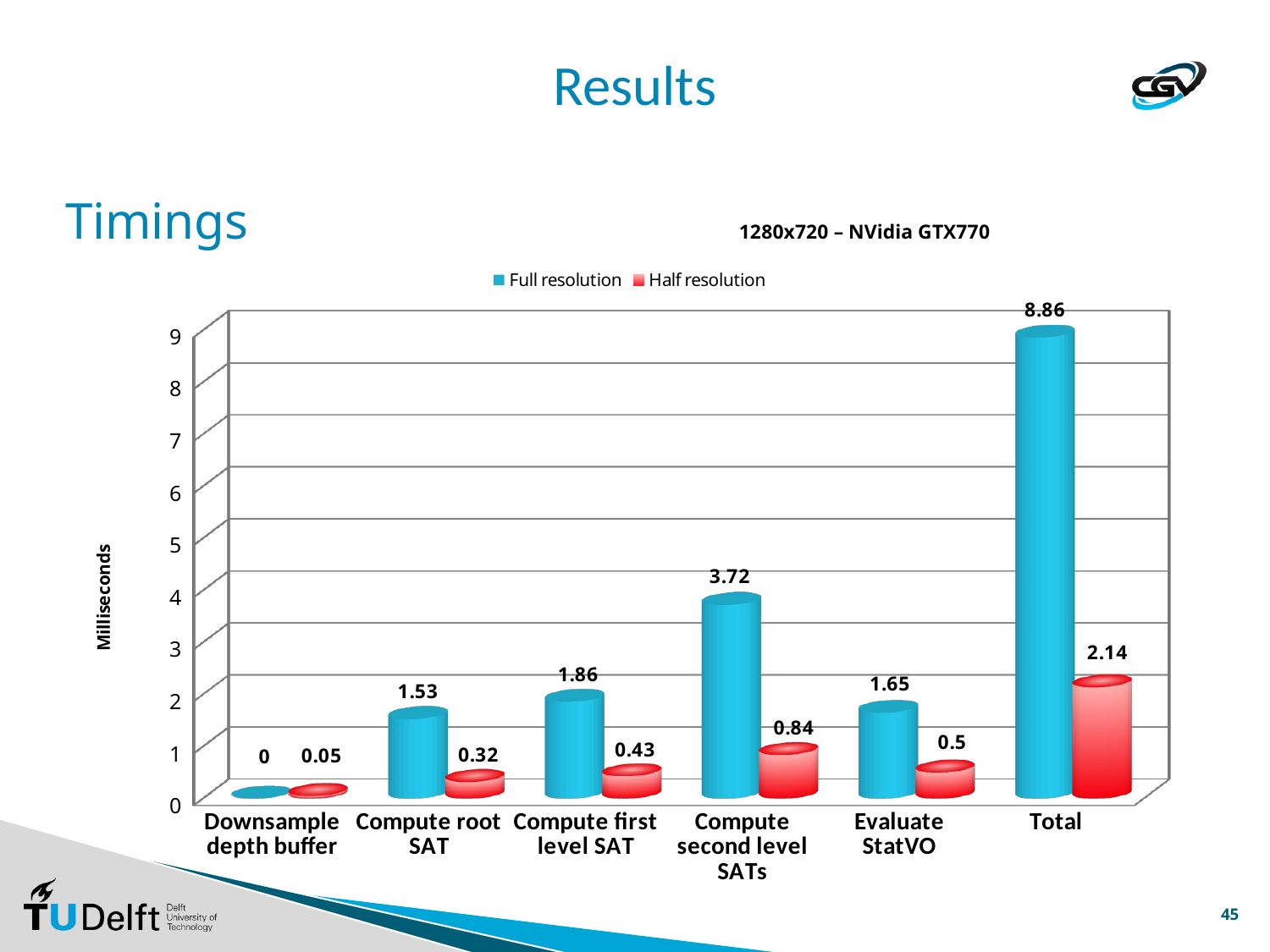
How many series does the legend list? 2 How many categories are shown on the x axis? 6 Which category has the lowest Half resolution value? Downsample depth buffer What is the Full resolution value for Total? 8.86 What is the Half resolution value for Evaluate StatVO? 0.5 What is the label of the y axis? Milliseconds What kind of chart is shown? Bar chart What is the Full resolution value for Compute second level SATs? 3.72 Excluding Total, which category has the highest Full resolution value? Compute second level SATs What is the Half resolution value for Compute root SAT? 0.32 Which is larger: the Full resolution value for Compute first level SAT or for Evaluate StatVO? Compute first level SAT What is the difference between the Full resolution and Half resolution values for Total? 6.72